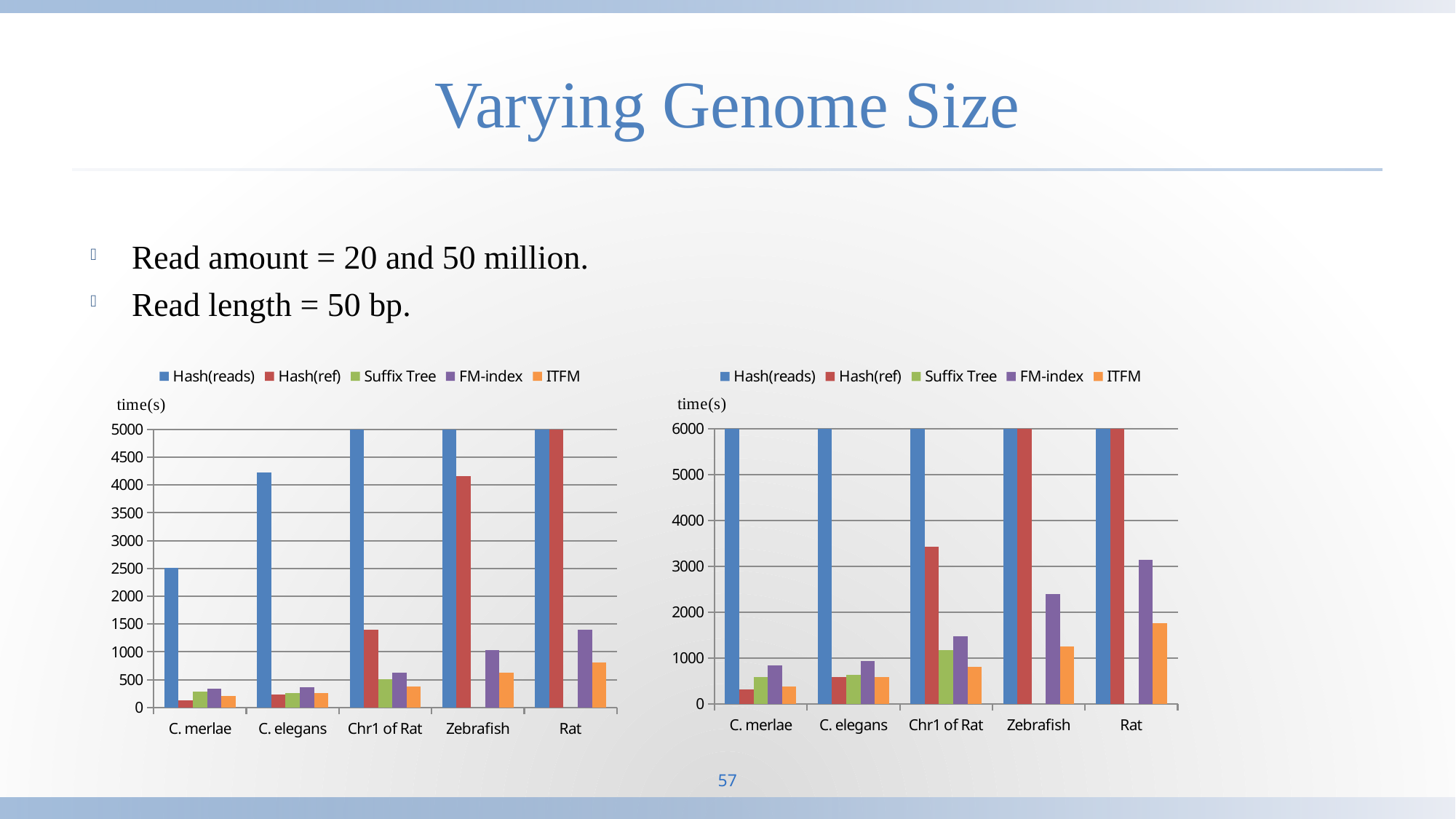
In the right chart, is the Hash(ref) value for Chr1 of Rat greater or less than 3000? greater In the right chart, which has the larger Suffix Tree value, C. elegans or Chr1 of Rat? Chr1 of Rat What is the y-axis label of the right chart? time(s) In the right chart, is the ITFM value for Zebrafish greater or less than 1000? greater In the left chart, which has the larger FM-index value, Zebrafish or Rat? Rat In the right chart, is the FM-index value for Rat greater or less than 2500? greater What kind of chart is the left chart? bar chart How many categories are shown on the x axis of the right chart? 5 In the left chart, which category has the lowest Hash(reads) value? C. merlae How many series does the legend of the left chart list? 5